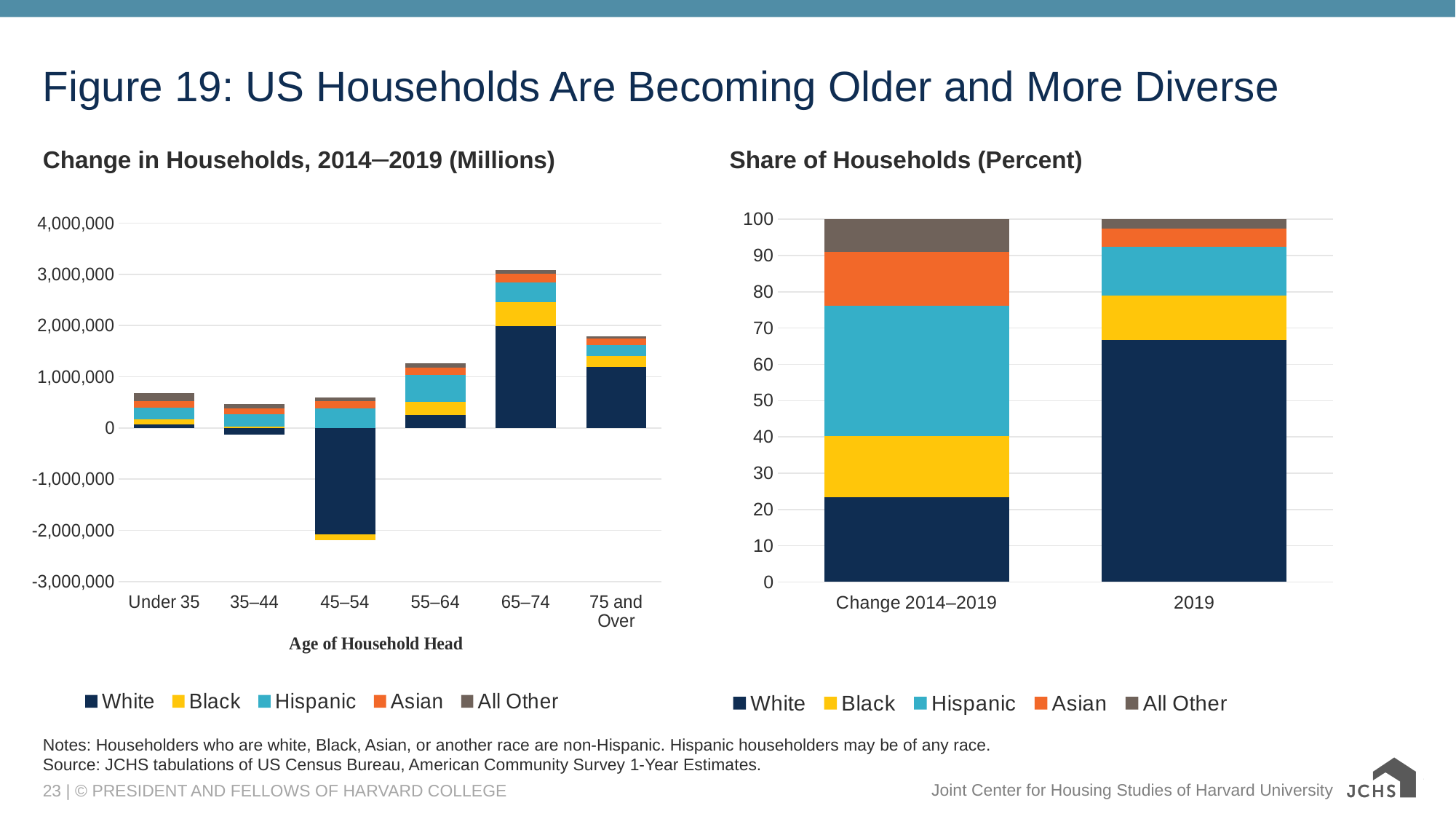
In the right chart, Share of Households (Percent), is the White share for Change 2014–2019 greater or less than 30? less In the left chart, Change in Households, 2014–2019, is the change for White households aged 45–54 greater or less than -1,000,000? less In the right chart, Share of Households (Percent), is the Hispanic share larger for Change 2014–2019 or for 2019? Change 2014–2019 What is the x-axis title of the left chart, Change in Households, 2014–2019? Age of Household Head In the right chart, Share of Households (Percent), is the White share for 2019 greater or less than 60? greater In the left chart, Change in Households, 2014–2019, which age group has the largest total increase in households? 65–74 How many series does the legend of the left chart, Change in Households, 2014–2019, list? 5 How many age groups are shown on the x axis of the left chart, Change in Households, 2014–2019? 6 What kind of chart is the right chart, Share of Households (Percent)? Stacked bar chart In the left chart, Change in Households, 2014–2019, which age group shows the largest decline in households? 45–54